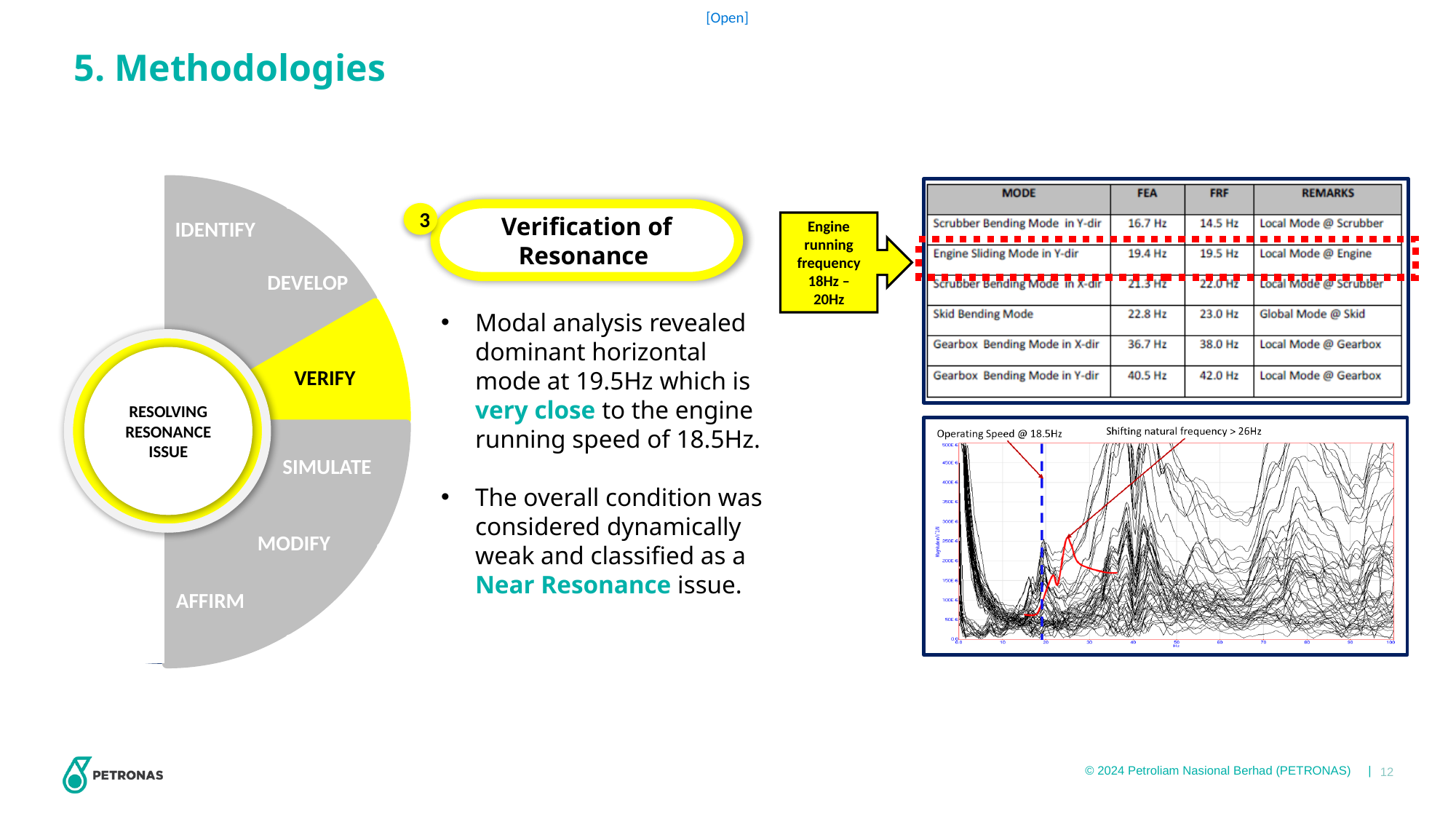
In the table at the top right, is the FEA value for Gearbox Bending Mode in X-dir larger or smaller than its FRF value? smaller In the table at the top right, which mode has the lowest FEA value? Scrubber Bending Mode in Y-dir In the table at the top right, how many modes are listed? 6 In the bottom-right chart, what is the highest value shown on the x axis? 100 In the bottom-right chart, what operating speed is marked by the dashed vertical line? 18.5Hz What kind of chart is shown in the bottom-right panel of the slide? line chart In the table at the top right, which mode has the highest FRF value? Gearbox Bending Mode in Y-dir In the table at the top right, what is the FRF value for Engine Sliding Mode in Y-dir? 19.5 Hz In the bottom-right chart, what does the annotation say the natural frequency is being shifted to? > 26Hz In the table at the top right, what is the difference between the FRF and FEA values for Skid Bending Mode? 0.2 Hz In the table at the top right, what is the FEA value for Scrubber Bending Mode in Y-dir? 16.7 Hz What engine running frequency range is stated in the yellow callout next to the table? 18Hz – 20Hz